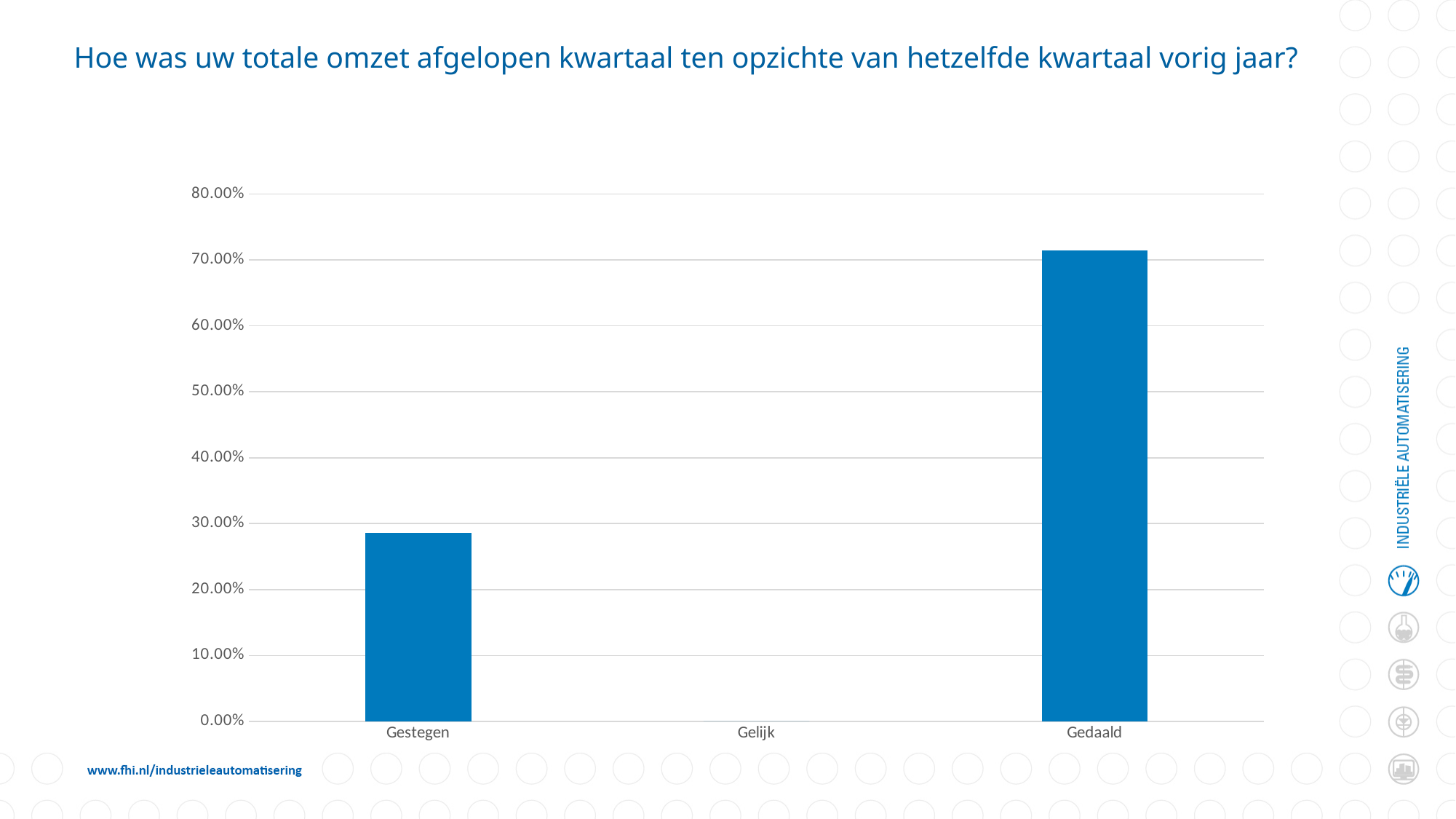
Which is larger, the value for Gestegen or the value for Gedaald? Gedaald What is the highest value shown on the y axis of the chart? 80.00% Is the value for Gedaald greater or less than 80.00%? less What kind of chart is shown on the slide? bar chart Is the value for Gestegen greater or less than 20.00%? greater Is the value for Gestegen greater or less than 30.00%? less Which category has the highest value in the chart? Gedaald What is the title of the slide above the chart? Hoe was uw totale omzet afgelopen kwartaal ten opzichte van hetzelfde kwartaal vorig jaar? Which category has the lowest value in the chart? Gelijk How many categories are shown on the x axis of the chart? 3